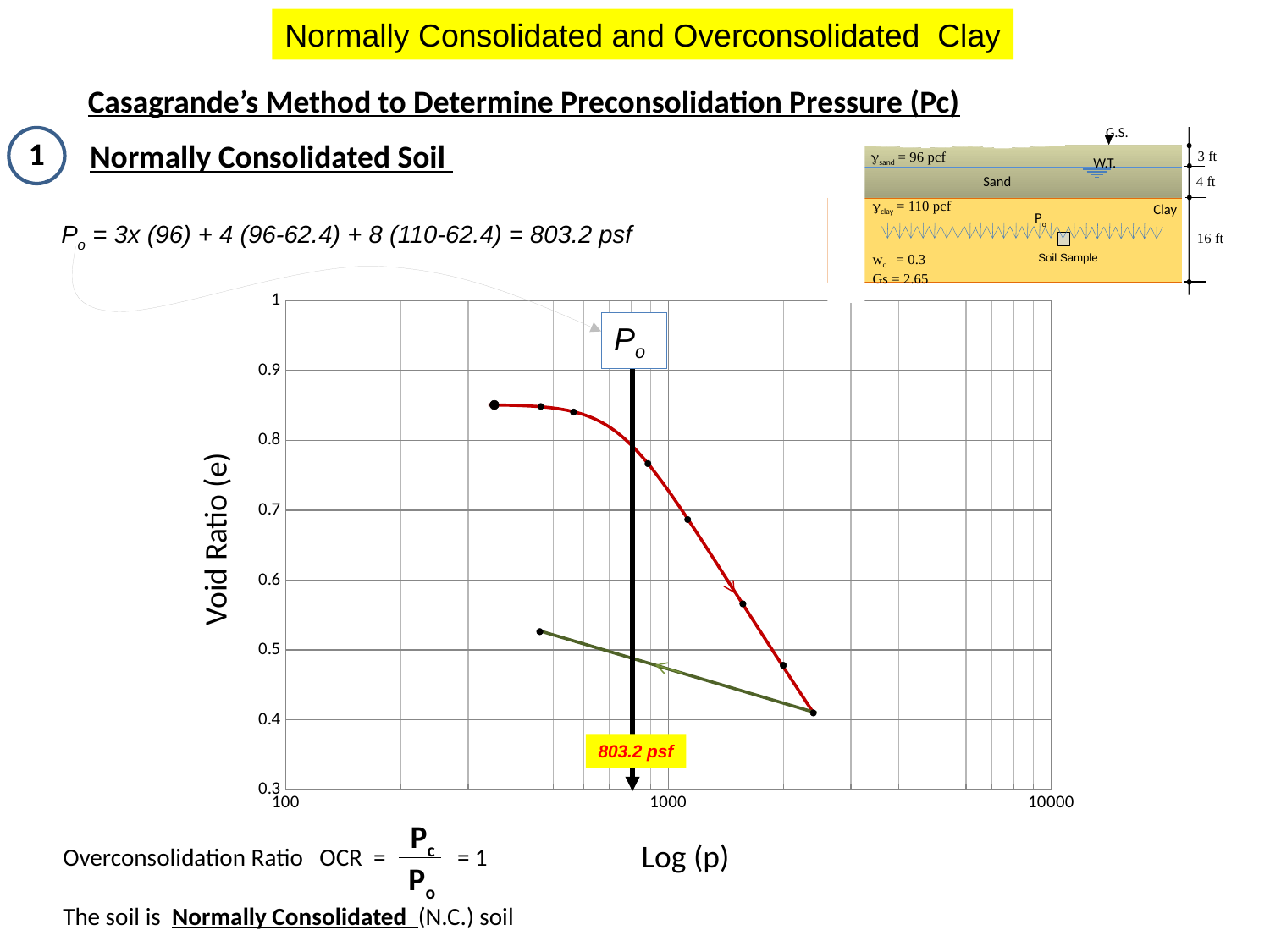
Is the void ratio of the left end of the green line greater or less than 0.5? greater Which has the larger void ratio on the red curve: the leftmost point or the rightmost point? the leftmost point What is the label of the vertical axis of the chart? Void Ratio (e) What is the lowest value shown on the vertical axis of the chart? 0.3 Is the void ratio of the leftmost point on the red curve greater or less than 0.8? greater Along the red curve, does the void ratio rise or fall as the pressure increases? fall What kind of chart is shown on the slide? line chart Is the void ratio of the rightmost point on the red curve greater or less than 0.5? less How many lines are plotted on the chart? 2 What pressure value is marked by the vertical Po arrow on the chart? 803.2 psf What is the label of the horizontal axis of the chart? Log (p)